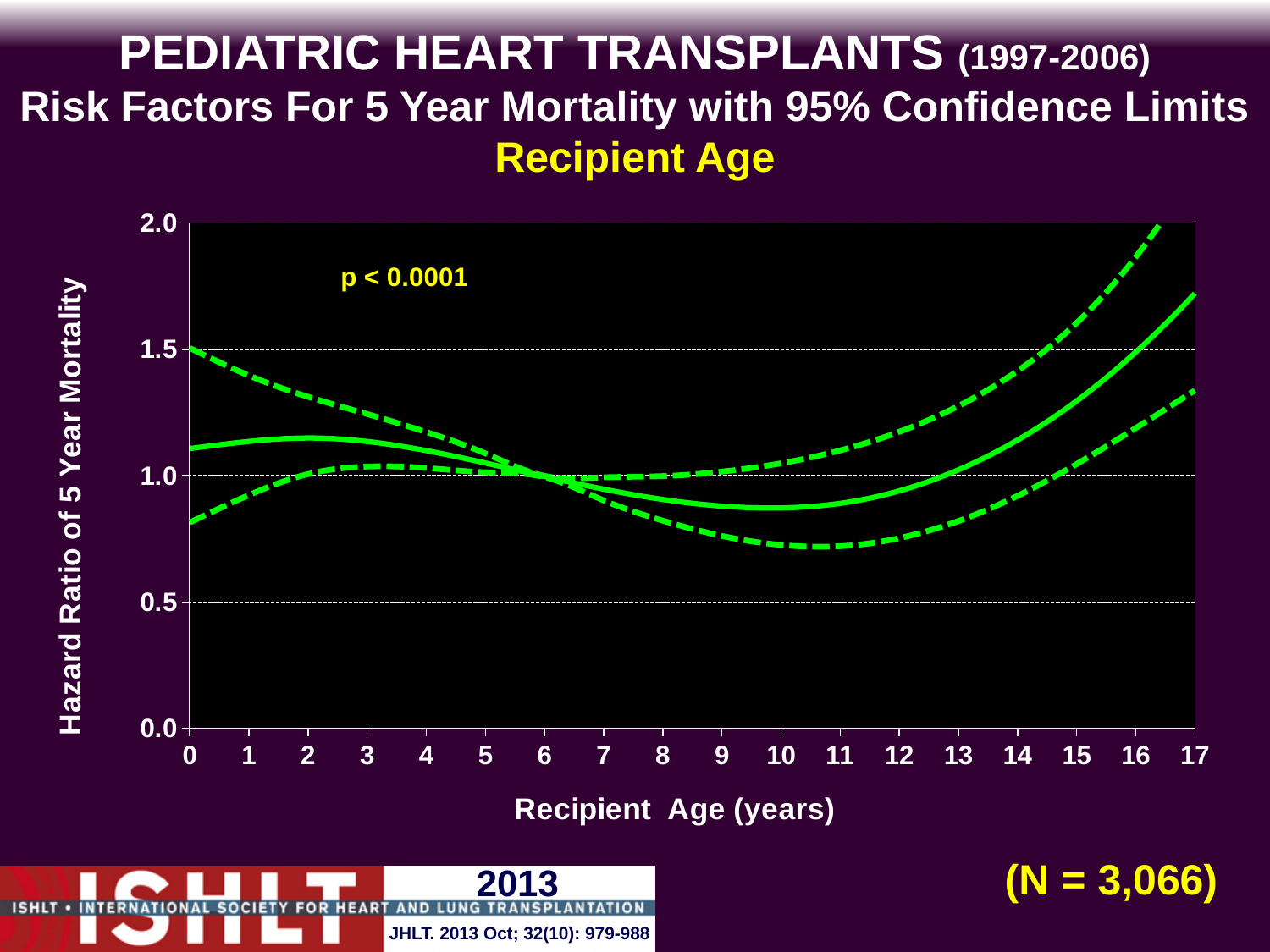
What is the label of the x axis? Recipient Age (years) What is the label of the y axis? Hazard Ratio of 5 Year Mortality Does the solid hazard ratio line rise or fall between recipient age 10 and recipient age 17? rise Is the hazard ratio on the solid line at recipient age 0 greater or less than 1.0? greater What kind of chart is shown on the slide? line chart Does the solid hazard ratio line rise or fall between recipient age 2 and recipient age 10? fall Is the lower dashed confidence limit at recipient age 10 greater or less than 1.0? less Is the upper dashed confidence limit at recipient age 16 greater or less than 1.5? greater What is the highest value shown on the y axis? 2.0 How many curves are plotted on the chart? 3